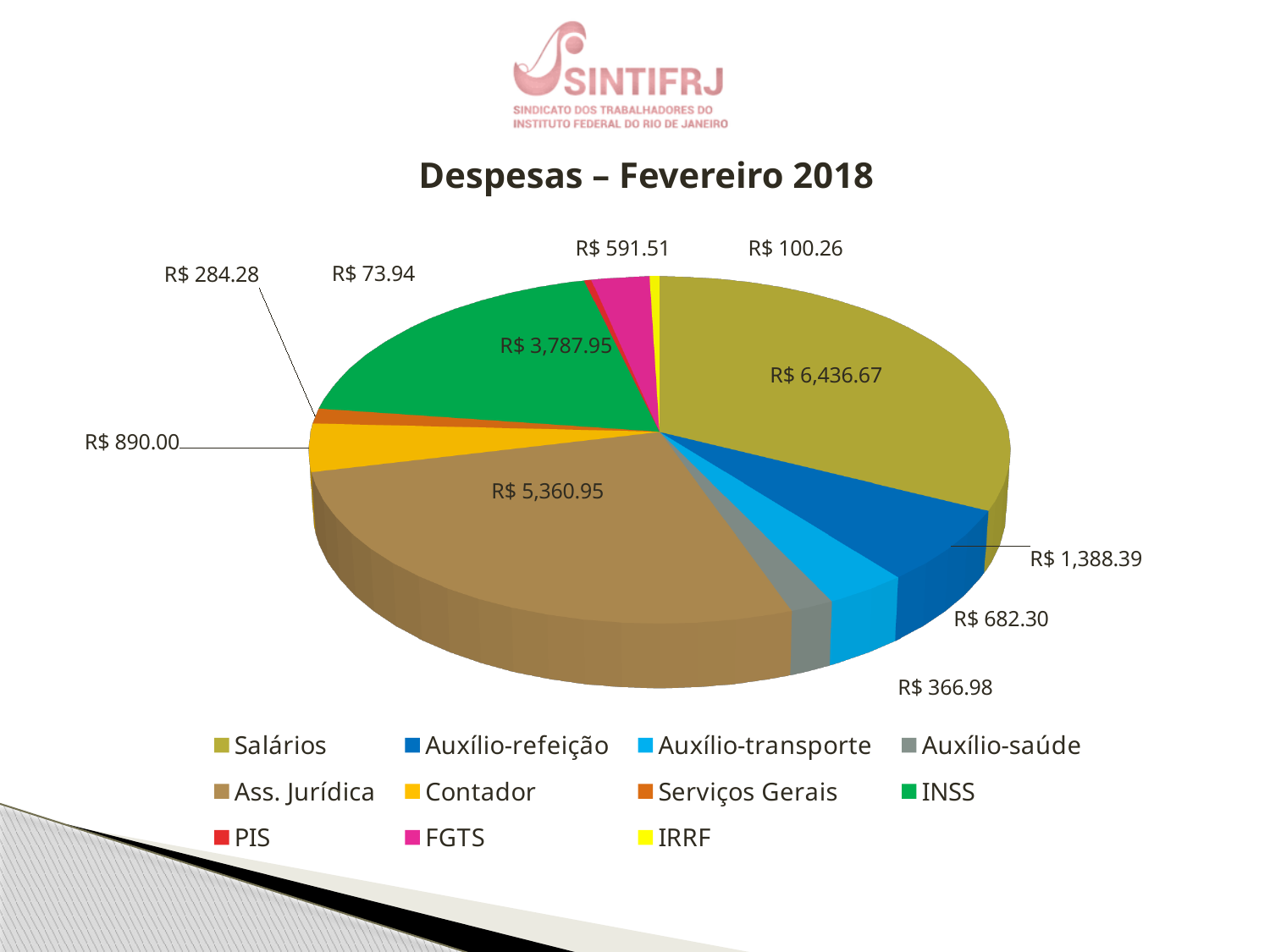
What is the value for Salários? R$ 6,436.67 What is the difference between Salários and Ass. Jurídica? R$ 1,075.72 What is the value for INSS? R$ 3,787.95 What is the title of the chart? Despesas – Fevereiro 2018 What is the value for Contador? R$ 890.00 Which category has the highest value? Salários What kind of chart is shown on the slide? Pie chart Which is larger, Auxílio-refeição or Auxílio-transporte? Auxílio-refeição What is the value for FGTS? R$ 591.51 What is the value for Ass. Jurídica? R$ 5,360.95 How many categories does the pie chart show? 11 Which category has the lowest value? PIS